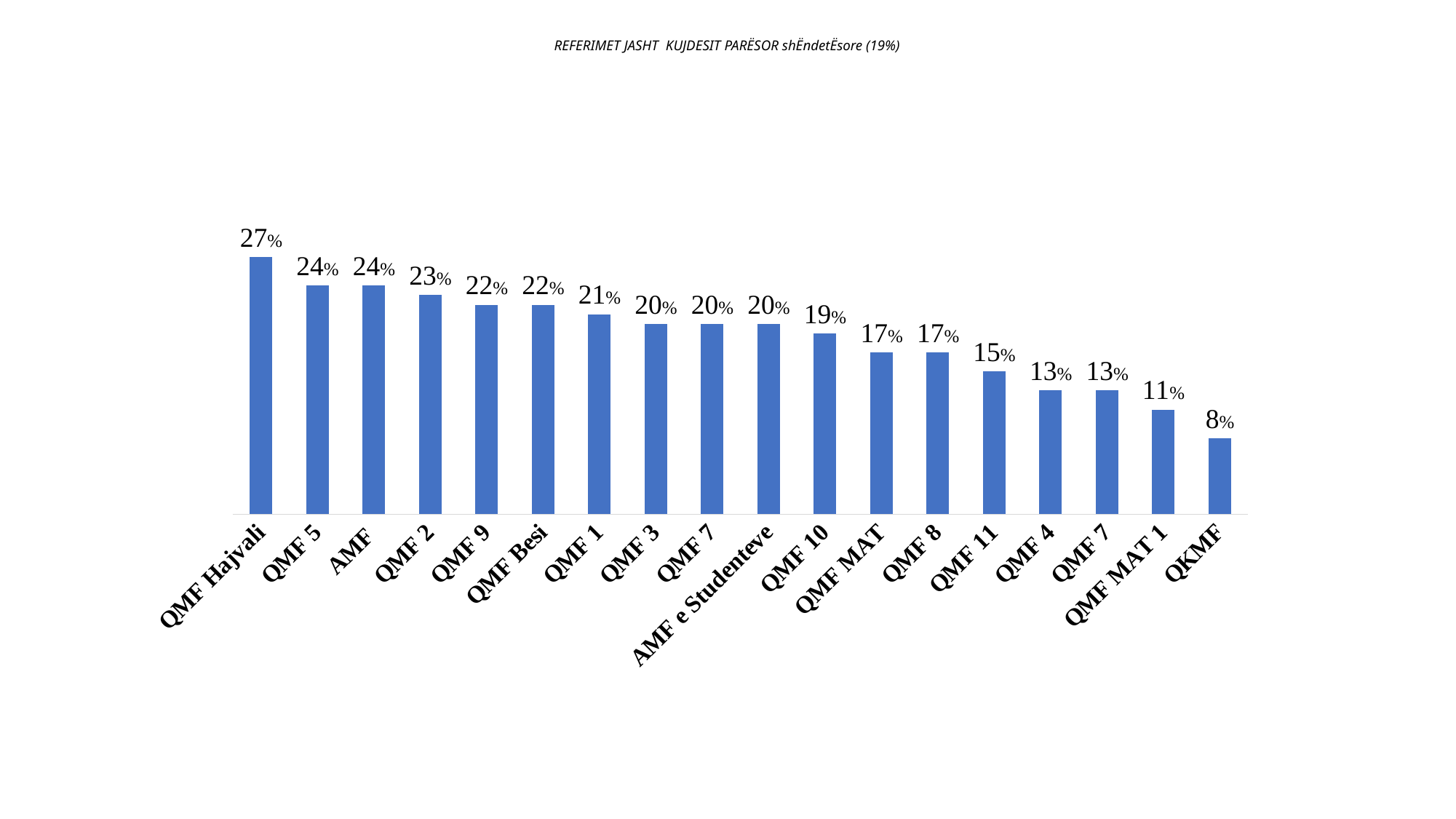
How many bars are shown in the chart? 18 What is the value for QMF MAT 1? 11% Which is larger, the value for QMF 5 or the value for QMF 2? QMF 5 What kind of chart is shown on the slide? Bar chart Do the values rise or fall from left to right along the x axis? Fall What is the value for QMF 11? 15% What is the difference between the values for QMF Hajvali and QKMF? 19 percentage points What is the value for AMF e Studenteve? 20% What is the value for QMF Hajvali? 27% Which category has the lowest value? QKMF Which category has the highest value? QMF Hajvali What is the value for QKMF? 8%